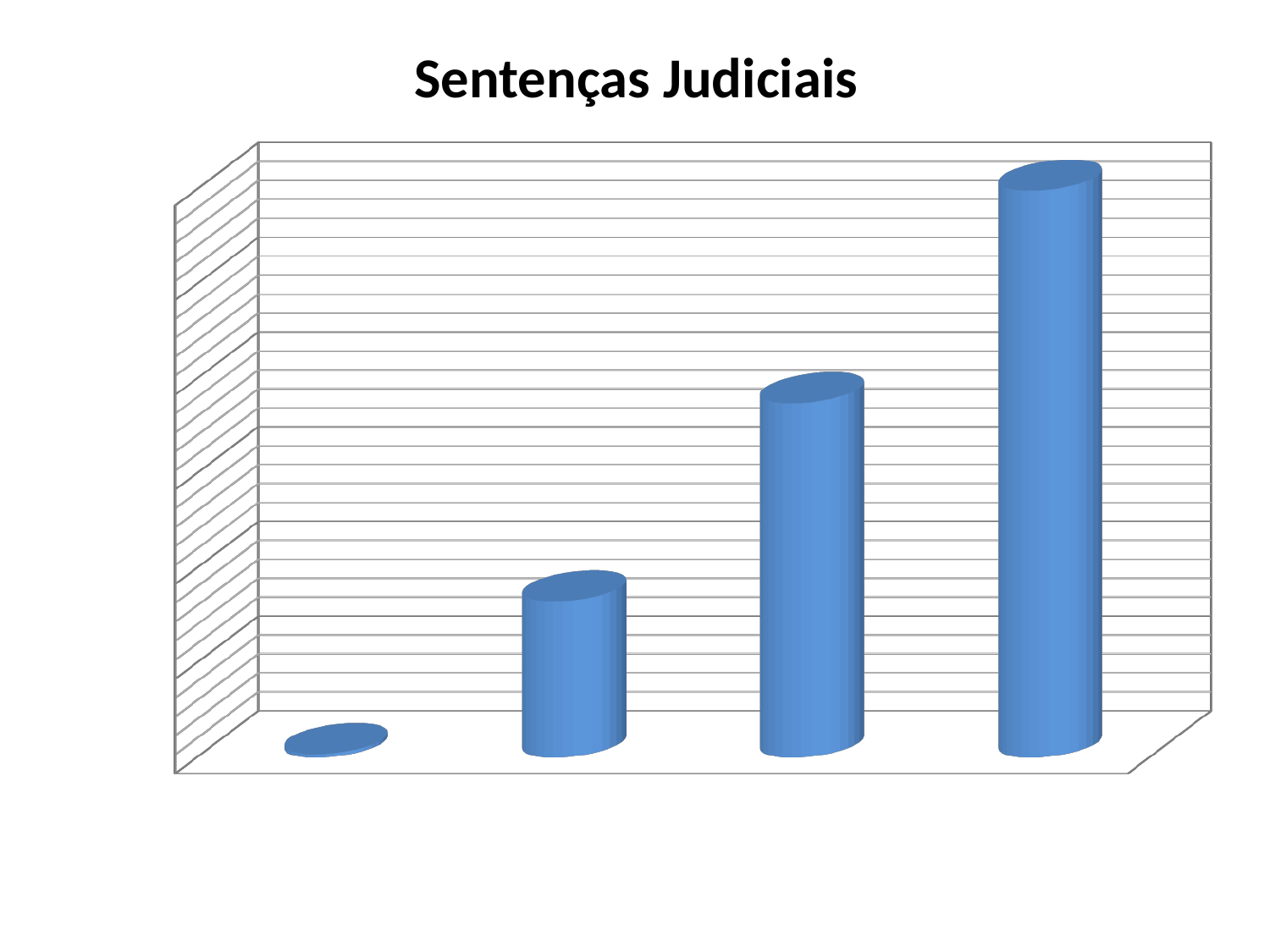
What kind of chart is shown on the slide? bar chart What is the title of the chart? Sentenças Judiciais Do the bar values rise or fall from left to right across the chart? rise Which is taller, the leftmost bar or the rightmost bar? the rightmost bar Which bar is the tallest in the chart? the rightmost bar How many bars are plotted in the chart? 4 Which bar is the shortest in the chart? the leftmost bar What colour are the bars in the chart? blue Which is taller, the second bar from the left or the third bar from the left? the third bar from the left